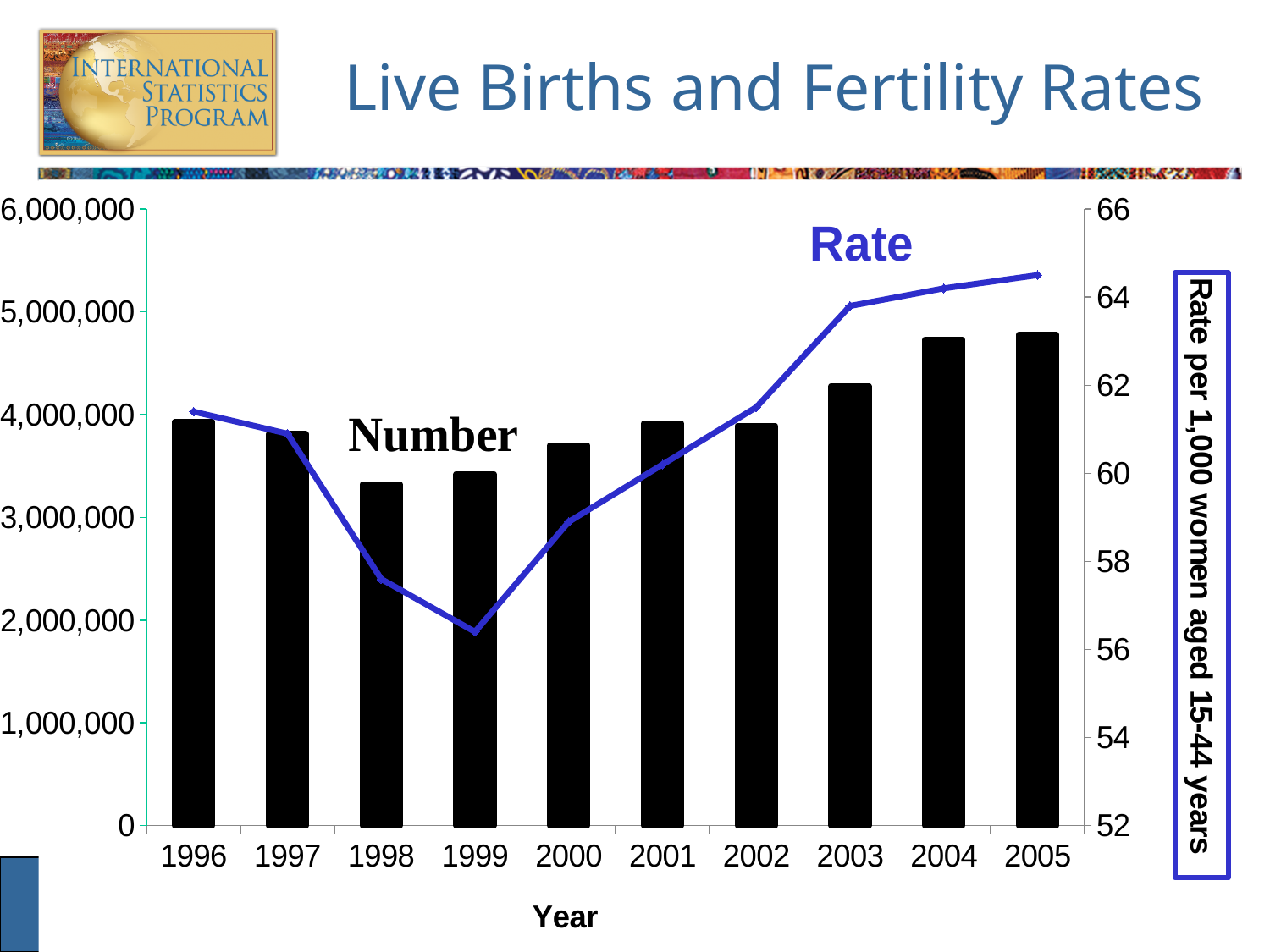
Does the Rate line rise or fall from 1999 to 2005? rise Which year has the larger Number value, 1998 or 2003? 2003 What is the title of the slide's chart? Live Births and Fertility Rates Is the Number value for 2004 greater or less than 4,000,000? greater How many years are shown on the x axis of the chart? 10 Is the Number value for 1998 greater or less than 4,000,000? less Which year has the lowest bar for Number? 1998 In which year is the Rate line at its lowest point? 1999 Is the Rate value for 1999 greater or less than 58? less What kind of chart is this? Combined bar and line chart What is the label on the right-hand vertical axis? Rate per 1,000 women aged 15-44 years